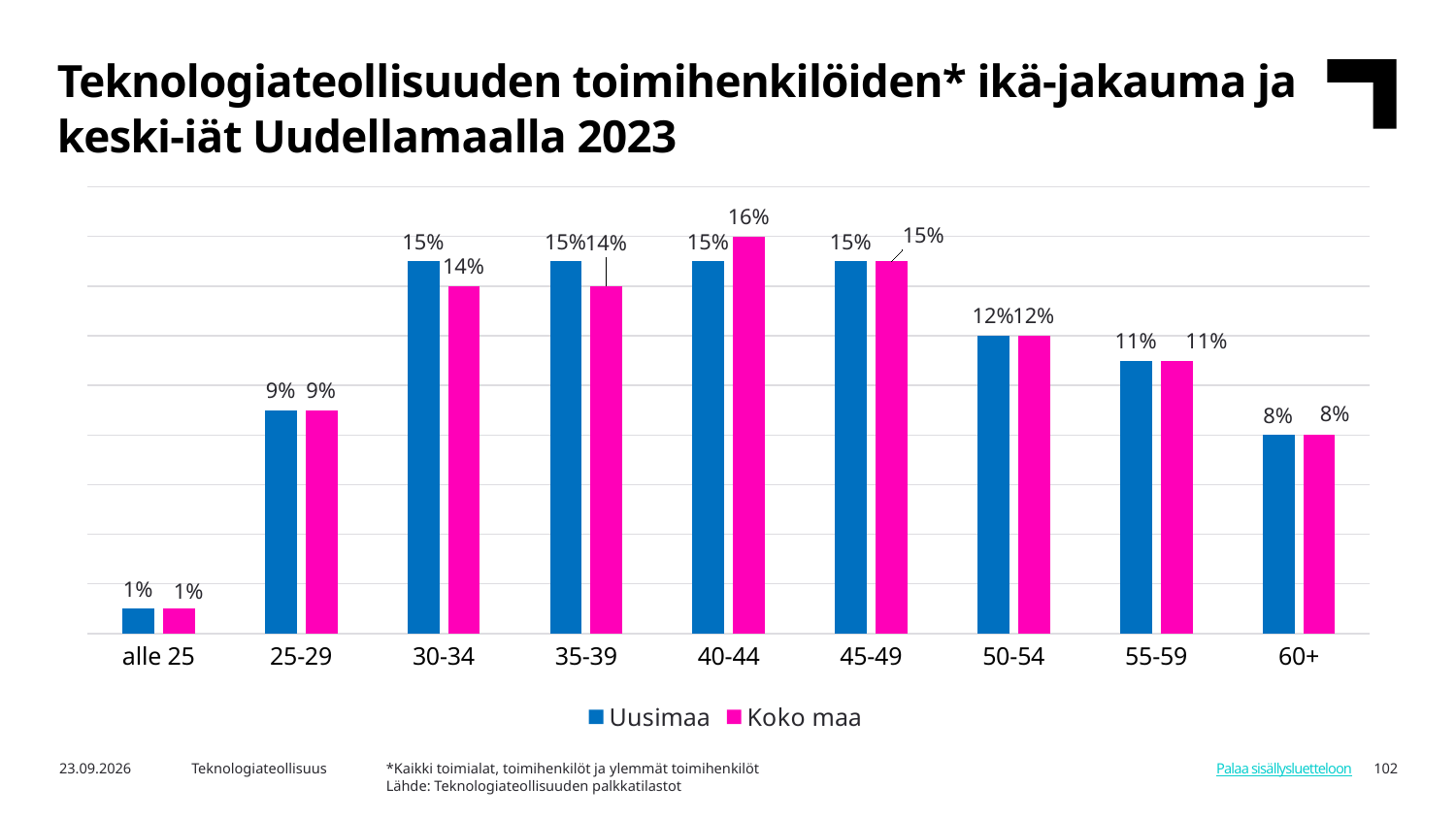
Which age group has the lowest Uusimaa value? alle 25 For the 40-44 age group, which series has the larger value, Uusimaa or Koko maa? Koko maa What is the Koko maa value for the 35-39 age group? 14% Which age group has the highest Koko maa value? 40-44 How many series does the legend list? 2 What kind of chart is shown on the slide? Bar chart What is the Uusimaa value for the 60+ age group? 8% What is the difference between the Uusimaa and Koko maa values for the 30-34 age group? 1% What is the Uusimaa value for the 30-34 age group? 15% Which series is shown in pink? Koko maa What is the Koko maa value for the 40-44 age group? 16% How many age groups are shown on the x axis? 9